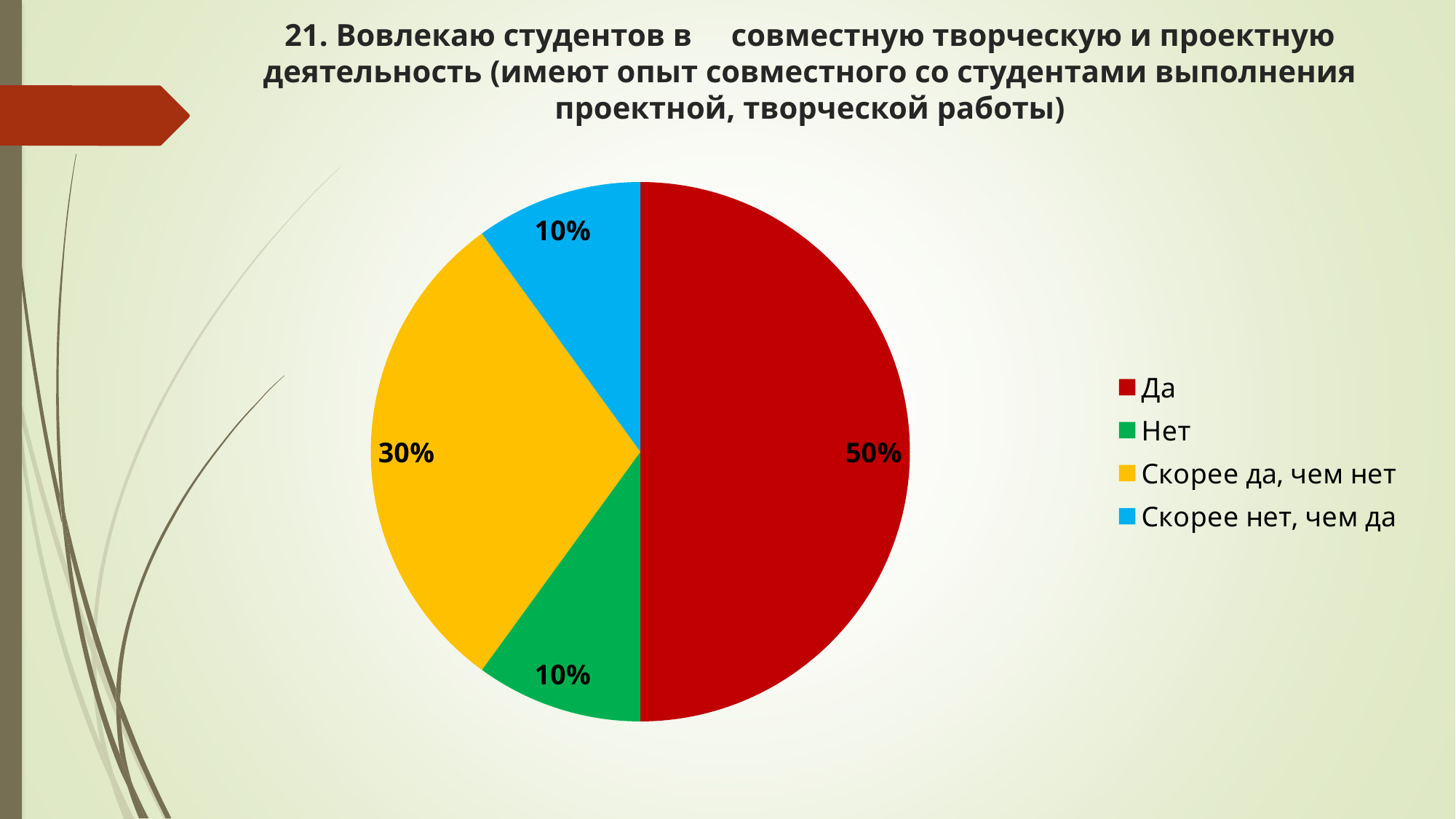
What share of the pie does "Скорее да, чем нет" have? 30% How many entries does the legend list? 4 What share of the pie does "Скорее нет, чем да" have? 10% What is the difference between the shares for "Да" and "Скорее да, чем нет"? 20% How many slices does the pie chart have? 4 What share of the pie does "Да" have? 50% Which is larger, the share for "Скорее да, чем нет" or the share for "Нет"? Скорее да, чем нет What colour is the slice for "Скорее нет, чем да"? blue What kind of chart is shown on the slide? pie chart What colour is the slice for "Да"? red Which category has the largest slice of the pie? Да